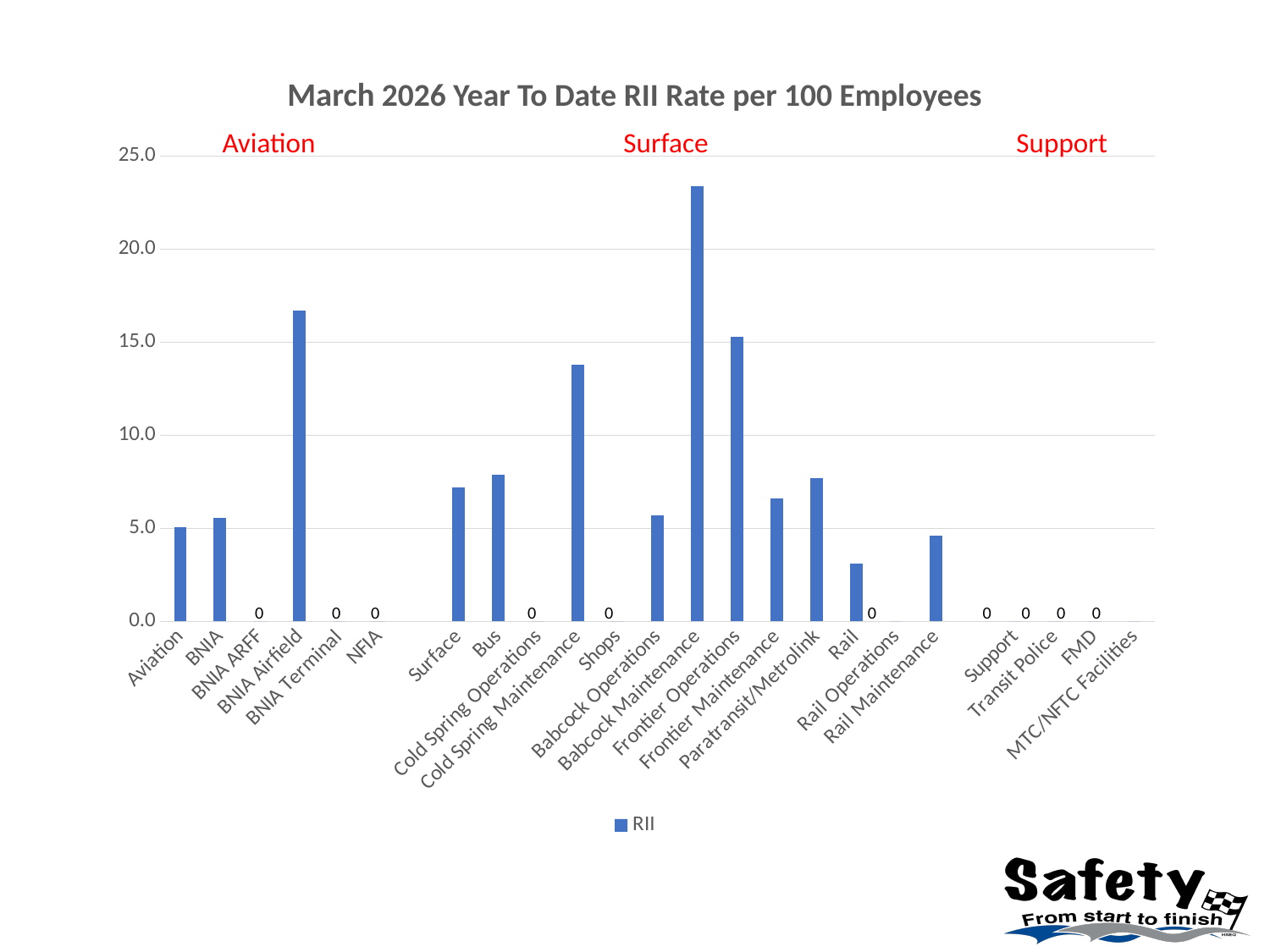
What is the RII rate shown for BNIA ARFF? 0 Is the value for BNIA Airfield greater or less than 15.0? greater How many categories are shown on the x axis? 23 Which category has the highest RII rate? Babcock Maintenance Is the value for Rail greater or less than 5.0? less What is the RII rate shown for Transit Police? 0 Is the value for Babcock Maintenance greater or less than 20.0? greater Which is larger, the value for BNIA Airfield or the value for Cold Spring Maintenance? BNIA Airfield What kind of chart is shown on the slide? bar chart How many categories have a data label of 0? 10 How many series does the legend list? 1 What is the title of the chart? March 2026 Year To Date RII Rate per 100 Employees